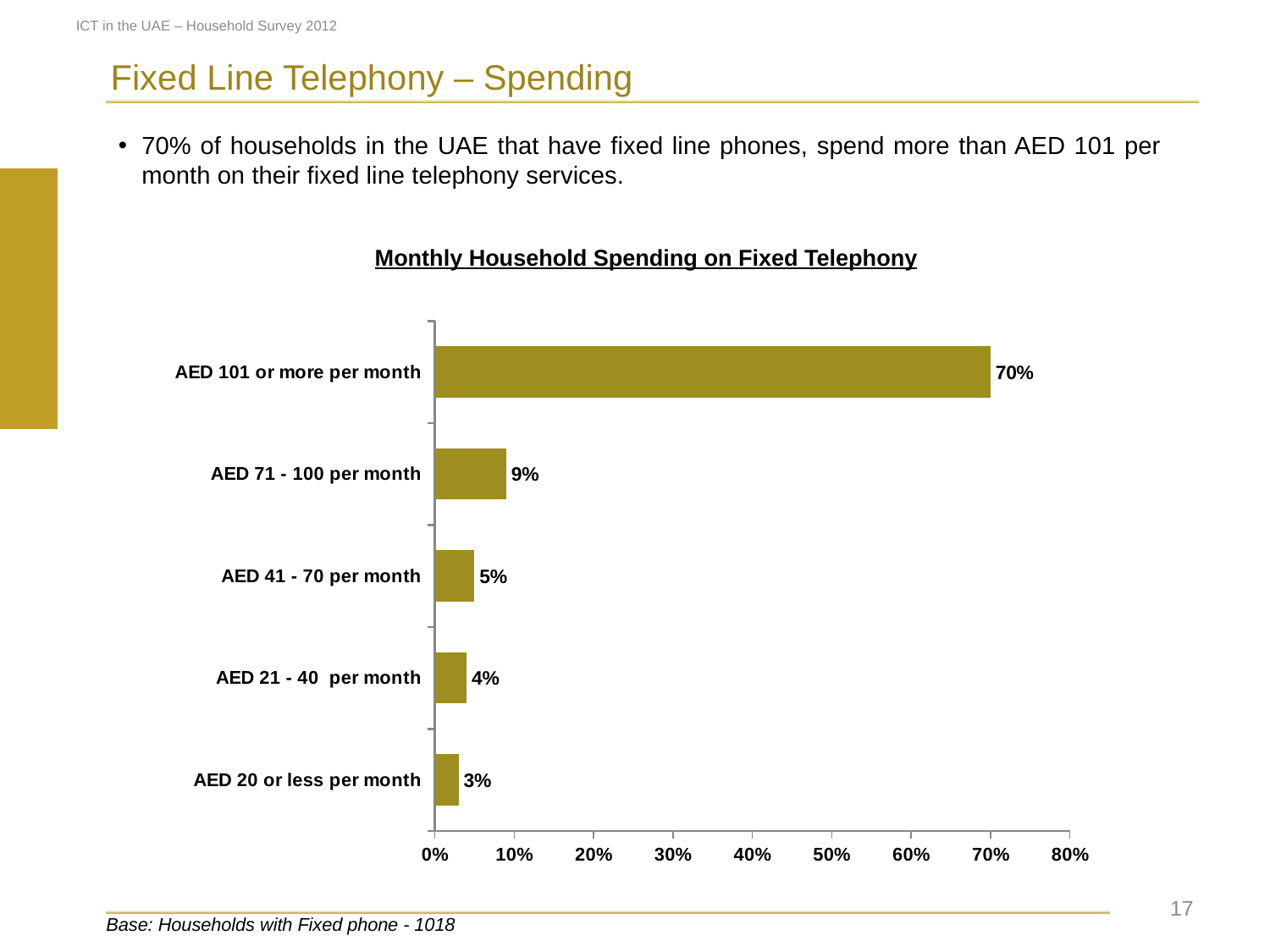
What is the title of the chart? Monthly Household Spending on Fixed Telephony What type of chart is shown on the slide? Bar chart How many spending categories are shown in the chart? 5 Which is larger, the value for AED 71 - 100 per month or AED 41 - 70 per month? AED 71 - 100 per month What is the value for AED 71 - 100 per month? 9% What is the difference between the values for AED 101 or more per month and AED 71 - 100 per month? 61% What is the value for AED 20 or less per month? 3% Which spending category has the highest value? AED 101 or more per month What percentage of households spend AED 101 or more per month on fixed telephony? 70% Is the value for AED 101 or more per month greater or less than 60%? greater Which spending category has the lowest value? AED 20 or less per month What is the difference between the values for AED 41 - 70 per month and AED 21 - 40 per month? 1%